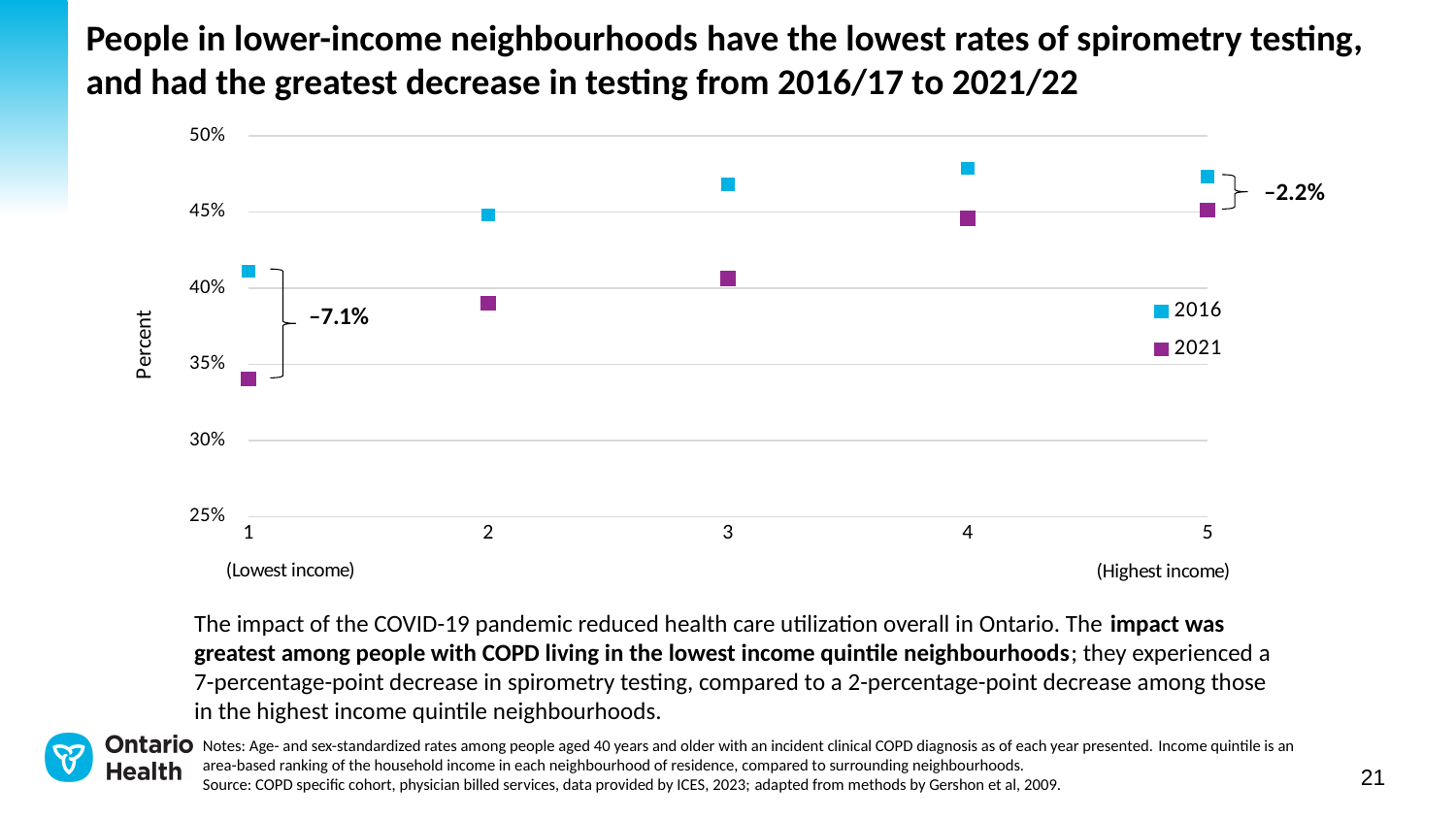
For income quintile 3, which is larger: the 2016 value or the 2021 value? 2016 How many series does the chart legend list? 2 What change in spirometry testing is annotated for income quintile 1 (lowest income) between 2016 and 2021? −7.1% Is the 2016 value for income quintile 4 greater or less than 45%? greater Which income quintile has the lowest 2021 value? 1 (Lowest income) Is the 2021 value for income quintile 2 greater or less than 40%? less What change in spirometry testing is annotated for income quintile 5 (highest income) between 2016 and 2021? −2.2% What kind of chart is shown on the slide? Scatter (dot) chart How many income quintiles are plotted along the x axis? 5 Which colour represents the 2021 series in the legend? Purple Which income quintile has the lowest 2016 value? 1 (Lowest income) Is the 2021 value for income quintile 1 greater or less than 35%? less